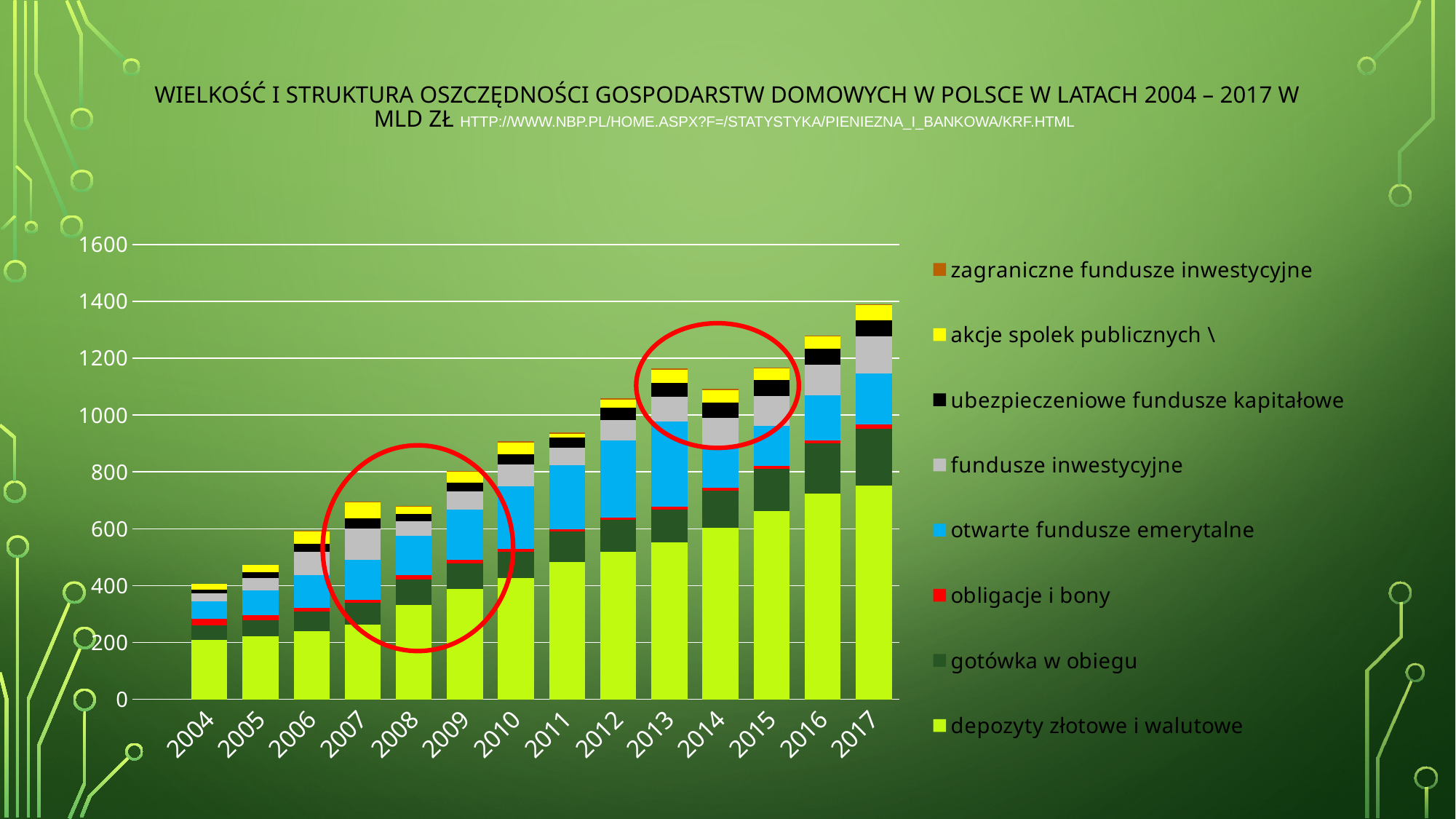
How many series does the chart's legend list? 8 Is the total height of the bar for 2017 greater or less than 1200? greater What kind of chart is shown on the slide? Stacked bar chart Which series is shown at the bottom of each stacked bar, in bright green? depozyty złotowe i walutowe Which year has the tallest stacked bar? 2017 Do the total bar heights generally rise or fall from 2004 to 2017? rise Which year has the shortest stacked bar? 2004 Is the total height of the bar for 2010 greater or less than 800? greater Is the total height of the bar for 2004 greater or less than 600? less How many years are shown on the x axis of the chart? 14 Which year has the taller stacked bar, 2013 or 2014? 2013